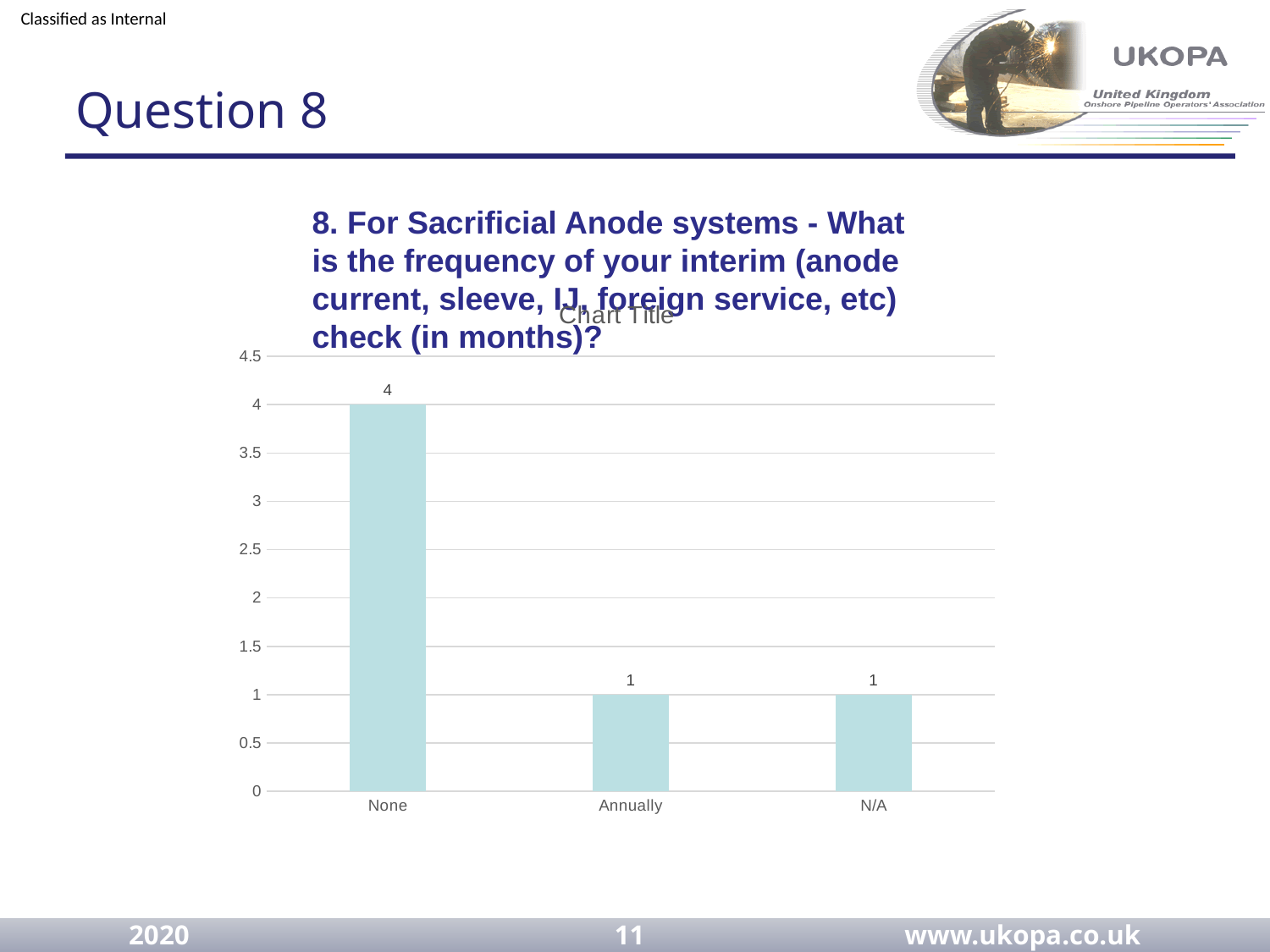
Is the value for None greater or less than 3? greater What is the value for N/A? 1 What kind of chart is shown? bar chart What is the total of the values across all three categories? 6 What is the highest value shown on the y axis? 4.5 What is the value for None? 4 Which is larger, the value for None or the value for N/A? None What is the difference between the values for None and Annually? 3 What is the value for Annually? 1 How many categories are shown on the x axis? 3 Which category has the highest value? None What is the placeholder title shown above the chart's plot area? Chart Title